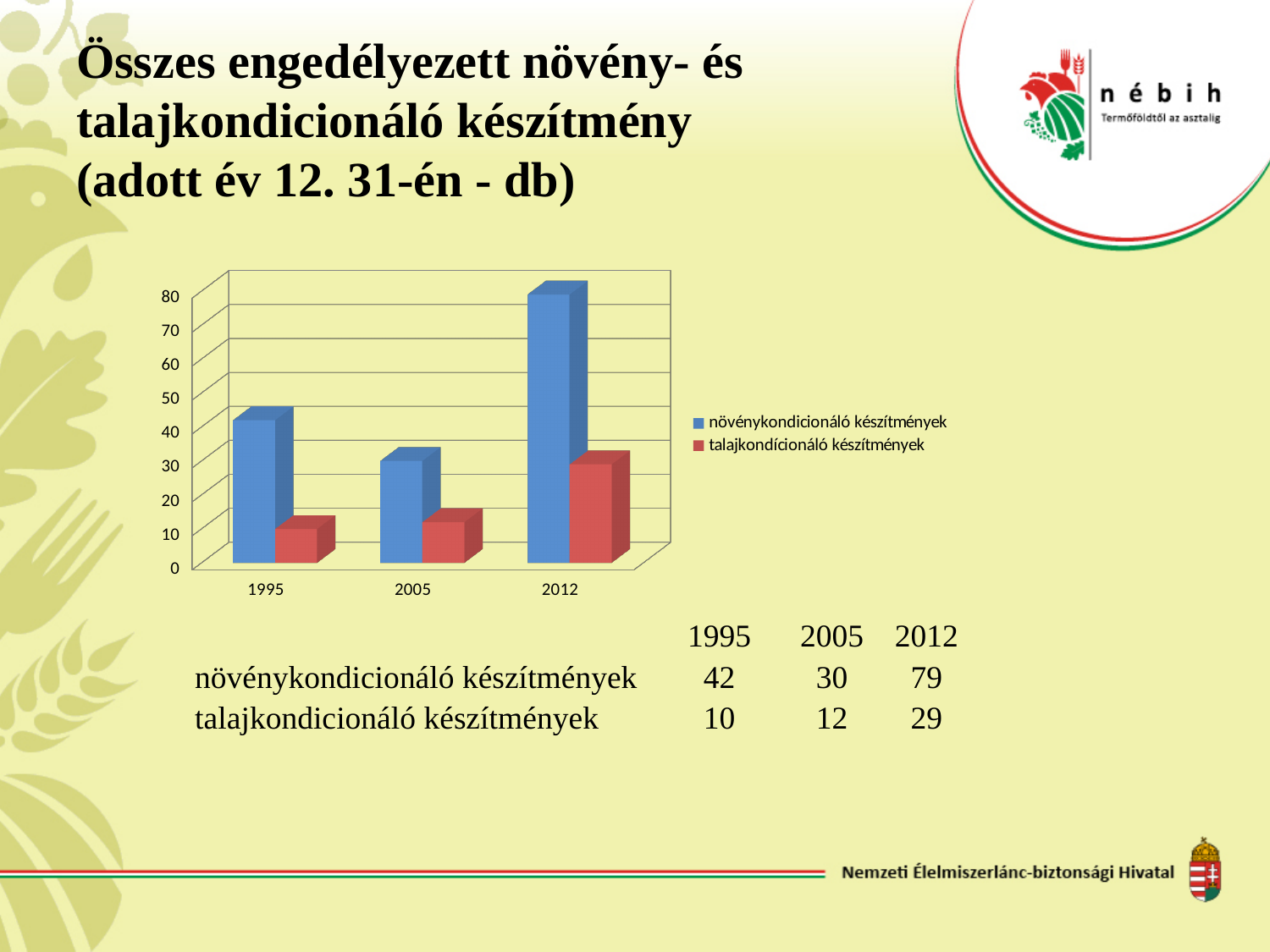
What is the value for talajkondicionáló készítmények in 1995? 10 In which year is the value for növénykondicionáló készítmények highest? 2012 How many years are shown on the x axis of the chart? 3 What is the value for növénykondicionáló készítmények in 2012? 79 Which is larger in 2005: növénykondicionáló készítmények or talajkondicionáló készítmények? növénykondicionáló készítmények What is the difference between növénykondicionáló készítmények and talajkondicionáló készítmények in 2012? 50 Which colour represents talajkondicionáló készítmények in the chart? red What is the value for növénykondicionáló készítmények in 2005? 30 What kind of chart is shown on the slide? bar chart How many series does the chart legend list? 2 In which year is the value for talajkondicionáló készítmények lowest? 1995 Is the value for növénykondicionáló készítmények in 1995 greater or less than 40? greater